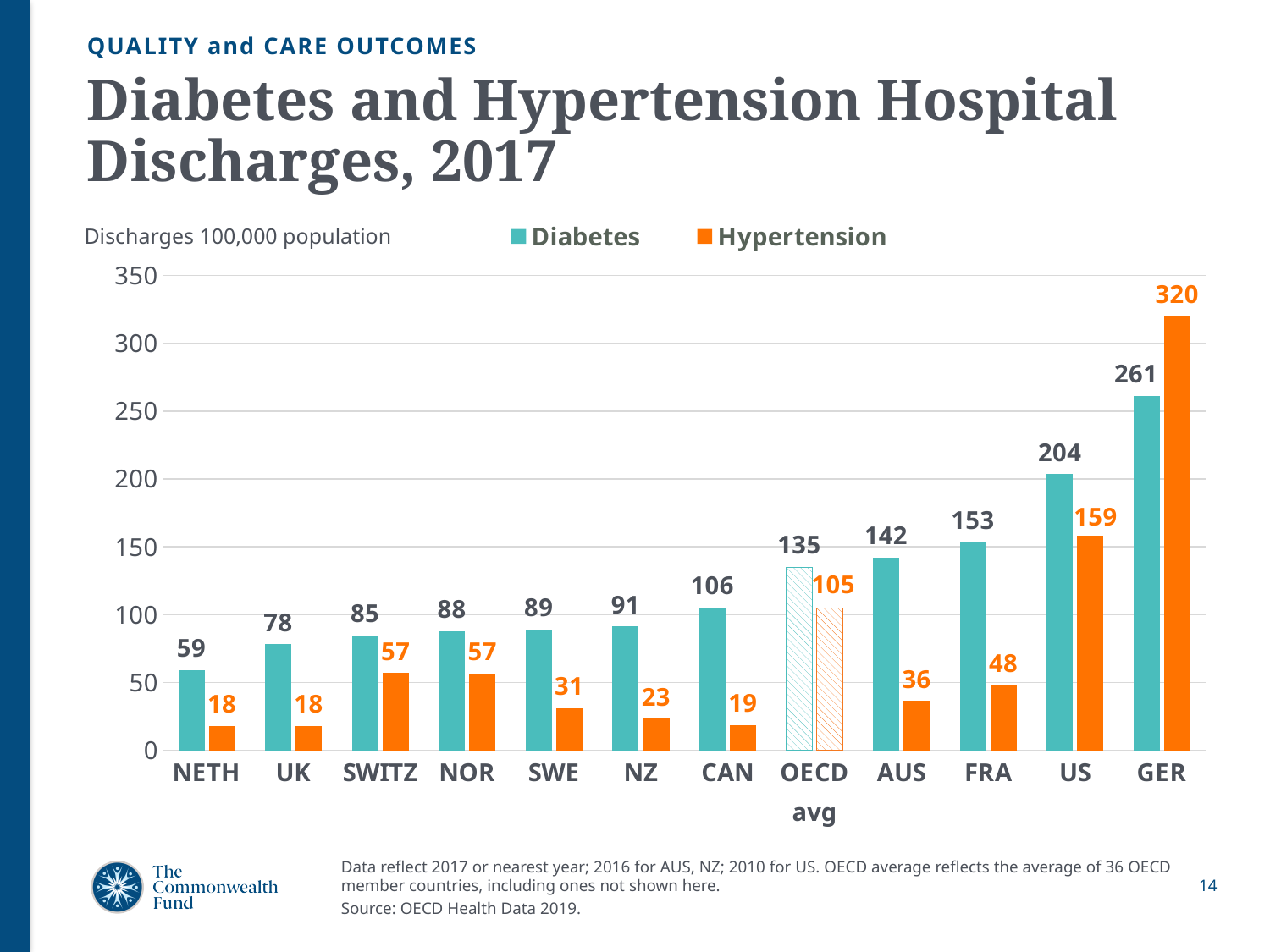
What is the difference between the Diabetes and Hypertension values for Germany (GER)? 59 Is the Diabetes value for France (FRA) greater or less than 150? greater How many countries or categories are shown on the x axis? 12 What is the Diabetes value for the OECD average? 135 What is the Hypertension discharge value for Germany (GER)? 320 How many series does the legend list? 2 Which country has the lowest Diabetes discharge value? NETH Which is larger, the Hypertension value for the US or the Hypertension value for the OECD average? US What is the Diabetes discharge value for the US? 204 What colour represents the Hypertension series in the legend? Orange Which country has the highest Diabetes discharge value? GER What kind of chart is shown on the slide? Bar chart